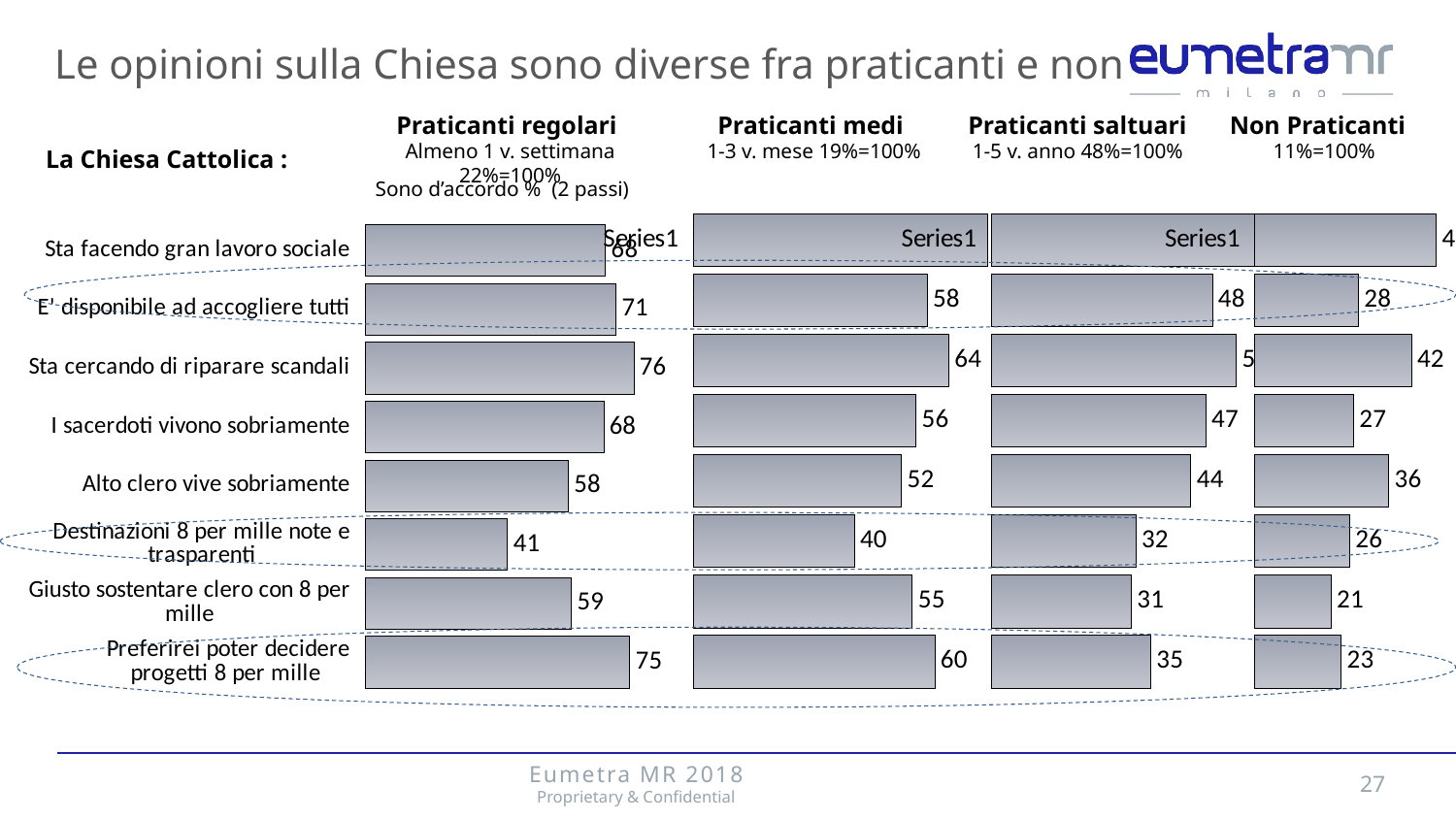
In the Praticanti medi chart, what is the value for "Destinazioni 8 per mille note e trasparenti"? 40 For "E' disponibile ad accogliere tutti", what is the difference between the Praticanti regolari value and the Non Praticanti value? 43 In the Praticanti medi chart, which category has the lowest value? Destinazioni 8 per mille note e trasparenti In the Non Praticanti chart, which is larger: "Sta cercando di riparare scandali" or "Alto clero vive sobriamente"? Sta cercando di riparare scandali For "Alto clero vive sobriamente", which group has the larger value: Praticanti medi or Praticanti saltuari? Praticanti medi What kind of chart is used for the Praticanti regolari data? Bar chart In the Praticanti medi chart, what is the difference between "Preferirei poter decidere progetti 8 per mille" and "Giusto sostenere clero con 8 per mille"? 5 In the Non Praticanti chart, what is the value for "Alto clero vive sobriamente"? 36 How many categories (statements) are plotted in the Praticanti regolari chart? 8 In the Praticanti regolari chart, what is the value for "Sta cercando di riparare scandali"? 76 In the Praticanti saltuari chart, what is the value for "I sacerdoti vivono sobriamente"? 47 In the Praticanti regolari chart, which category has the lowest value? Destinazioni 8 per mille note e trasparenti